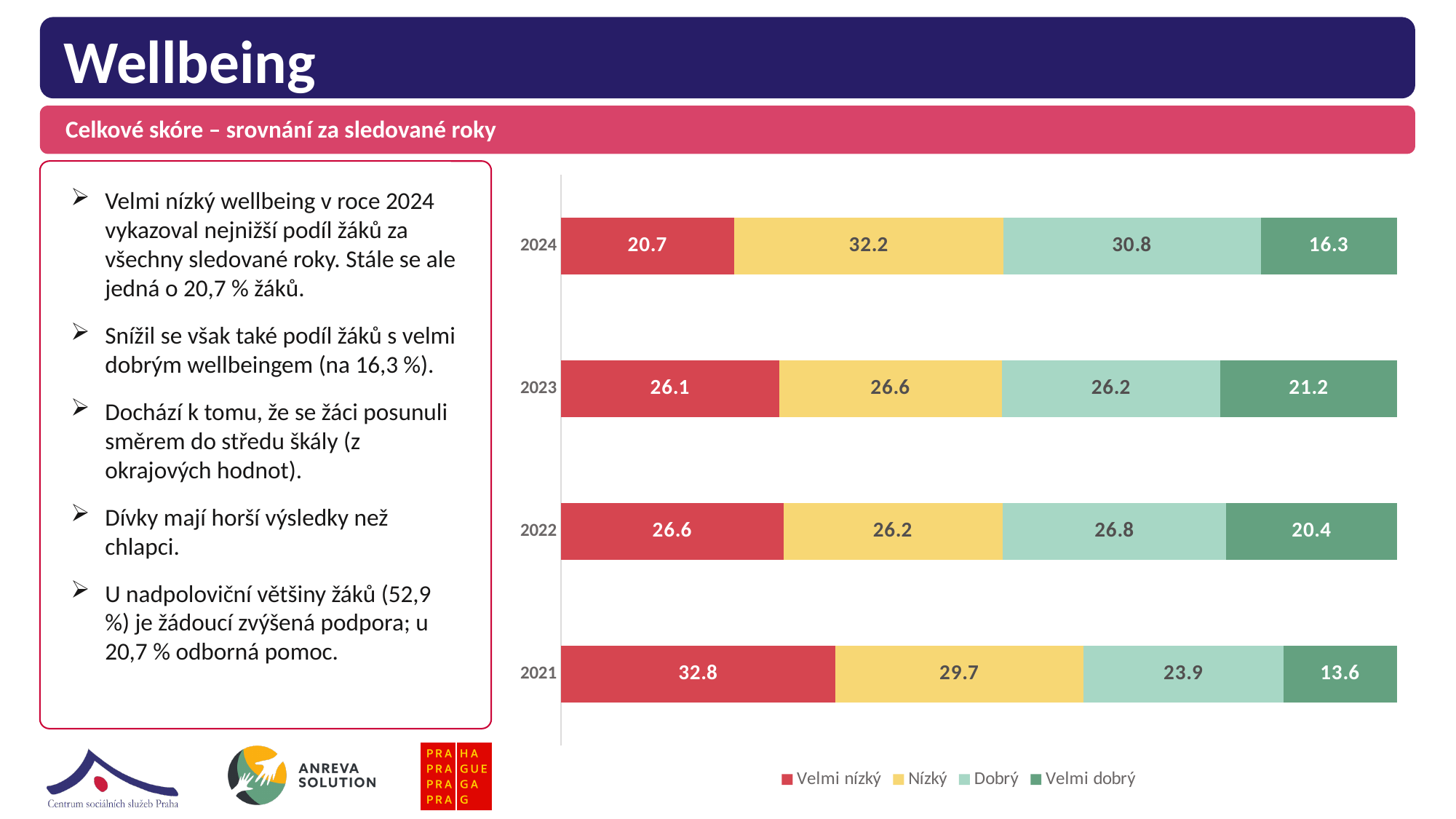
What colour represents the "Velmi nízký" series in the chart? Red Which year has the highest "Velmi nízký" value? 2021 What kind of chart is shown on the slide? Stacked bar chart What is the value of the "Velmi nízký" segment for 2024? 20.7 How many series does the legend list? 4 How many years are shown on the chart? 4 Which year has the lowest "Velmi dobrý" value? 2021 What is the difference between the "Velmi nízký" values for 2021 and 2024? 12.1 Which is larger: the "Nízký" value for 2024 or the "Nízký" value for 2021? 2024 What is the value of the "Nízký" segment for 2023? 26.6 What is the value of the "Dobrý" segment for 2022? 26.8 What is the value of the "Velmi dobrý" segment for 2021? 13.6